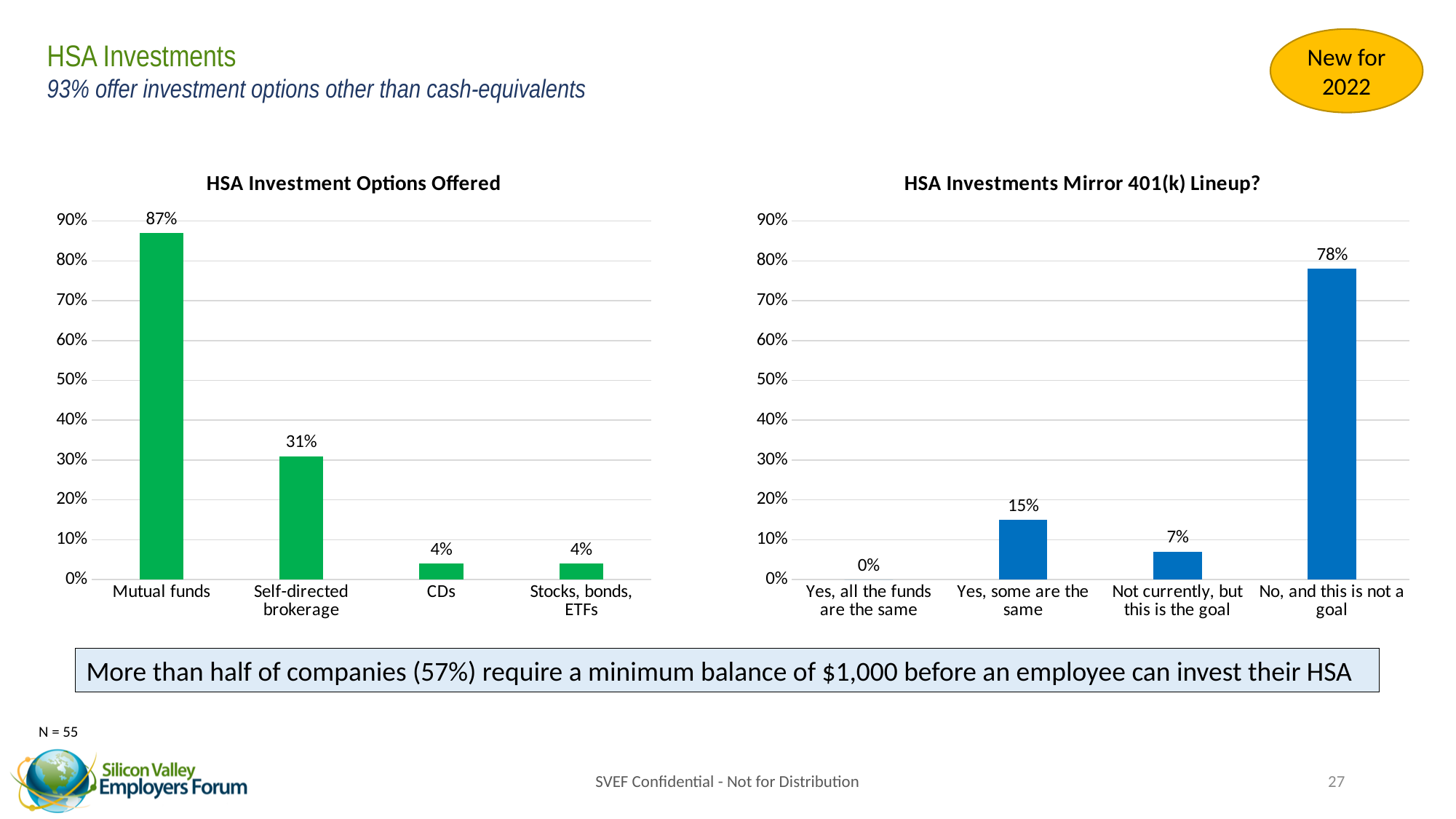
In the 'HSA Investments Mirror 401(k) Lineup?' chart, which is larger: 'Yes, some are the same' or 'Not currently, but this is the goal'? Yes, some are the same What kind of chart is 'HSA Investments Mirror 401(k) Lineup?'? Bar chart In the 'HSA Investment Options Offered' chart, what is the value for Mutual funds? 87% In the 'HSA Investments Mirror 401(k) Lineup?' chart, what is the difference between 'No, and this is not a goal' and 'Yes, some are the same'? 63% In the 'HSA Investment Options Offered' chart, how many categories are shown? 4 What colour are the bars in the 'HSA Investment Options Offered' chart? Green In the 'HSA Investment Options Offered' chart, what is the difference between Mutual funds and Self-directed brokerage? 56% In the 'HSA Investments Mirror 401(k) Lineup?' chart, what is the value for 'No, and this is not a goal'? 78% In the 'HSA Investments Mirror 401(k) Lineup?' chart, which category has the lowest value? Yes, all the funds are the same In the 'HSA Investment Options Offered' chart, which category has the highest value? Mutual funds In the 'HSA Investments Mirror 401(k) Lineup?' chart, what is the value for 'Yes, some are the same'? 15% In the 'HSA Investment Options Offered' chart, what is the value for Self-directed brokerage? 31%